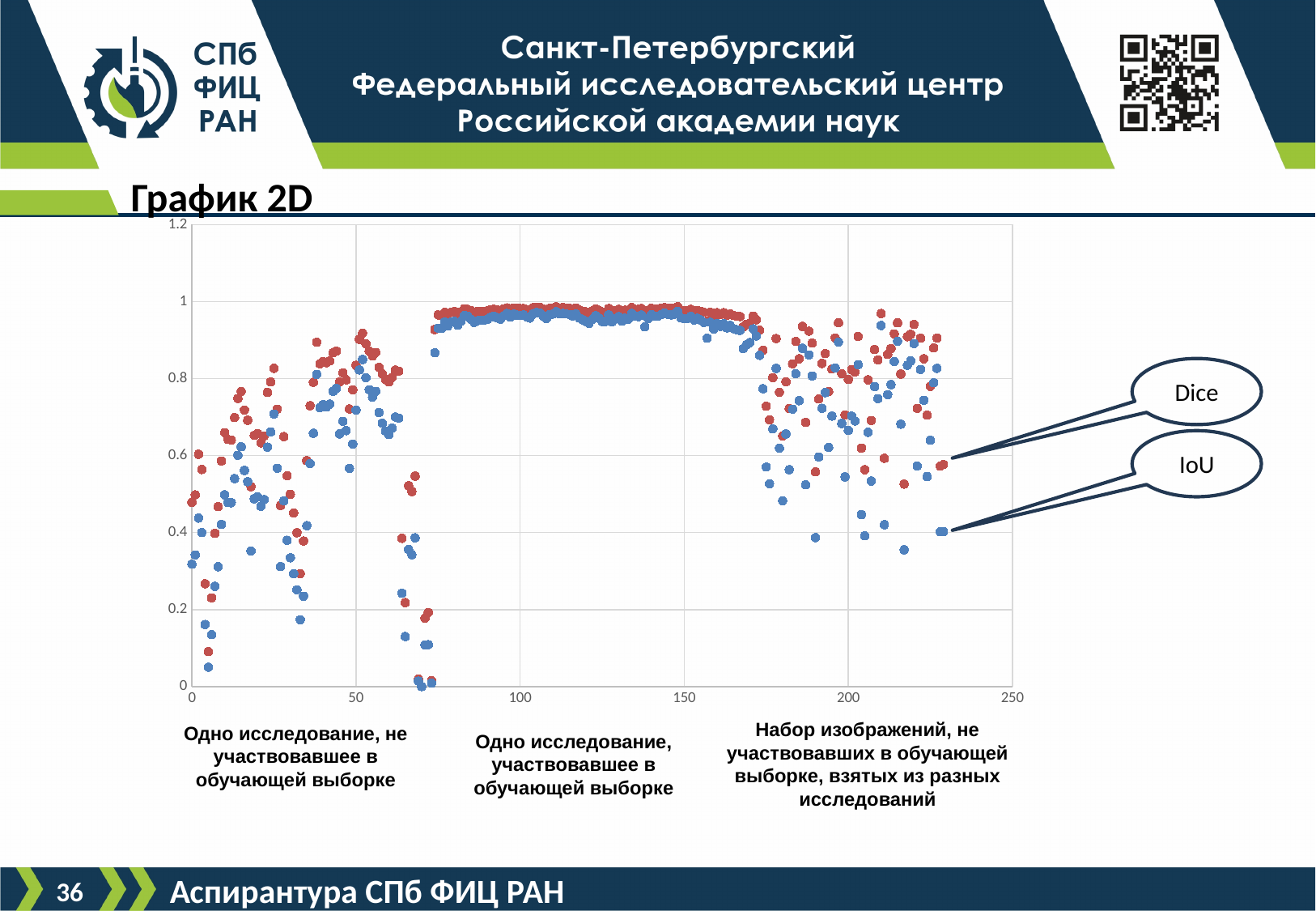
Are the values for the points between x = 75 and x = 170 (the study that was in the training set) greater or less than 0.8? greater What are the names of the two series labelled in the chart? Dice and IoU Which group of points has the most consistent (least scattered) values: the study not in the training set, the study in the training set, or the set of images from different studies? the study in the training set (Одно исследование, участвовавшее в обучающей выборке) What kind of chart is shown on the slide? scatter chart Are the values for the points between x = 75 and x = 170 greater or less than 1? less How many series are shown in the chart (as labelled by the callouts)? 2 What is the highest value shown on the horizontal axis? 250 How many labelled groups of data are annotated below the chart? 3 Which series, Dice or IoU, generally has the higher values in the chart? Dice